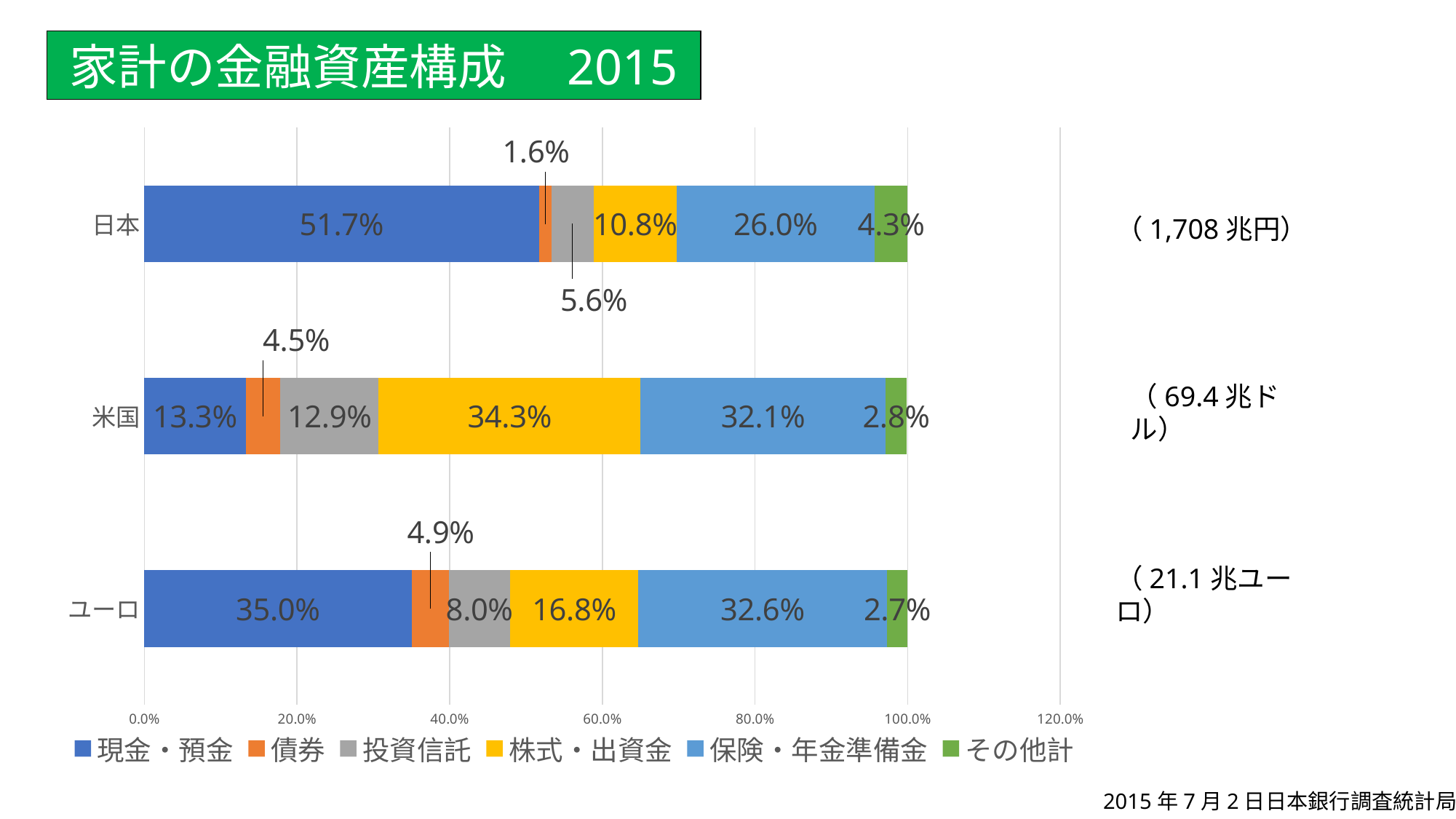
How many categories (regions) are plotted on the chart? 3 What is the share of 現金・預金 for 日本? 51.7% Which region has the highest share of 現金・預金? 日本 What is the difference between the 現金・預金 share of 日本 and that of 米国? 38.4% What is the share of 株式・出資金 for 米国? 34.3% What is the share of 保険・年金準備金 for ユーロ? 32.6% How many series does the legend list? 6 Which region has the lowest share of 株式・出資金? 日本 What is the title of the chart on the slide? 家計の金融資産構成 2015 What is the share of 債券 for 日本? 1.6% Which is larger: the 投資信託 share of 米国 or the 投資信託 share of ユーロ? 米国 What kind of chart is shown on the slide? Stacked bar chart